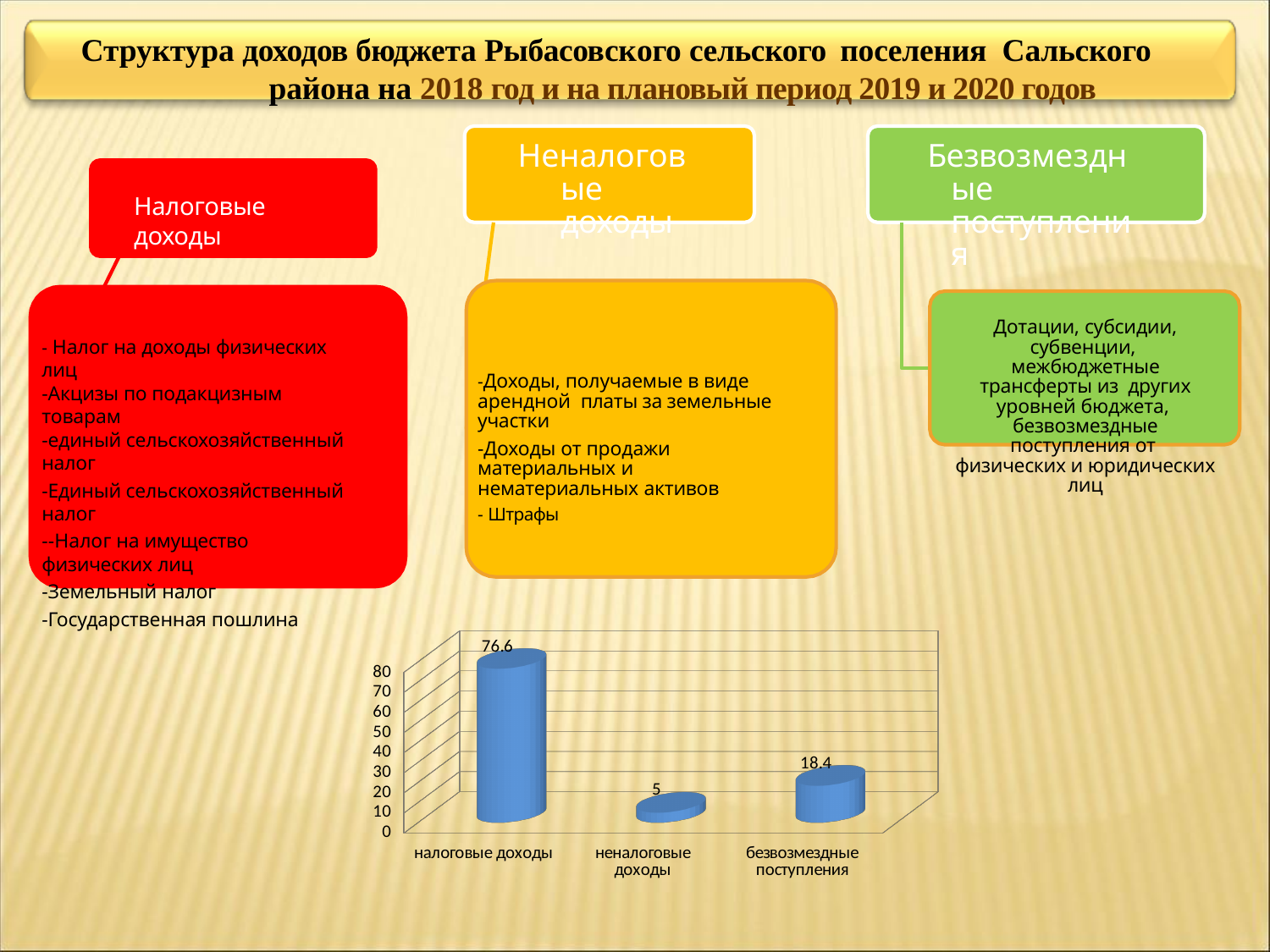
How many categories are shown on the chart? 3 What is the value for неналоговые доходы? 5 Which category has the lowest value? неналоговые доходы Which category has the highest value? налоговые доходы What is the value for безвозмездные поступления? 18.4 What kind of chart is shown on the slide? bar chart What is the difference between the values for безвозмездные поступления and неналоговые доходы? 13.4 What is the difference between the values for налоговые доходы and безвозмездные поступления? 58.2 Is the value for налоговые доходы greater or less than 70? greater Which is larger, the value for безвозмездные поступления or the value for неналоговые доходы? безвозмездные поступления What is the highest value shown on the vertical axis of the chart? 80 What is the value for налоговые доходы? 76.6